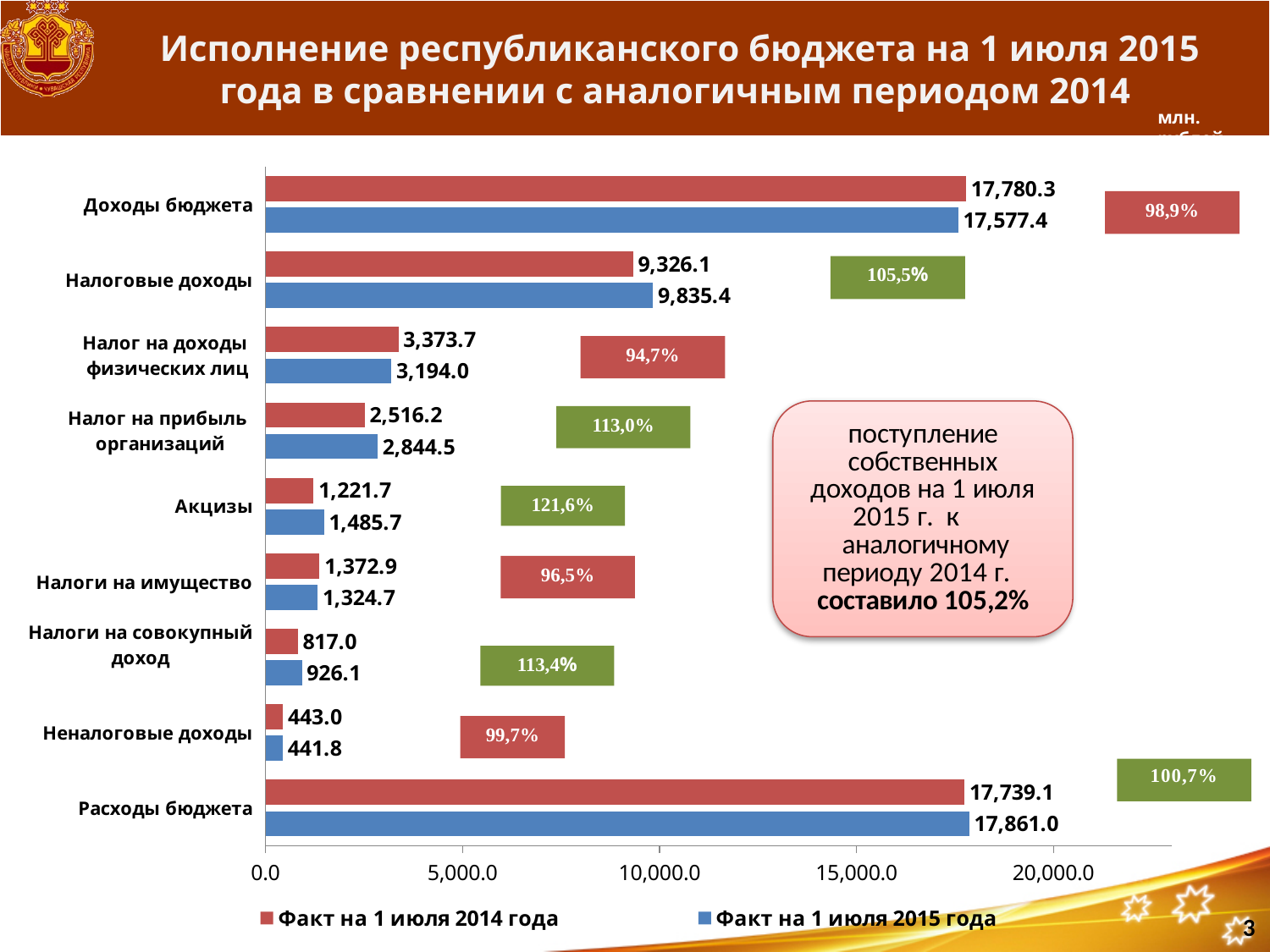
Which category has the highest value for "Факт на 1 июля 2014 года"? Доходы бюджета How many series does the legend list? 2 What is the value of "Факт на 1 июля 2014 года" for "Акцизы"? 1,221.7 What is the difference between the 2015 and 2014 values for "Акцизы"? 264.0 Which colour represents "Факт на 1 июля 2015 года" in the chart? blue How many categories are plotted on the chart? 9 For "Налог на доходы физических лиц", which is larger: the value for 2014 or for 2015? 2014 What is the value of "Факт на 1 июля 2015 года" for "Расходы бюджета"? 17,861.0 What is the difference between the 2015 and 2014 values for "Налоговые доходы"? 509.3 Which category has the lowest value for "Факт на 1 июля 2015 года"? Неналоговые доходы What kind of chart is shown on the slide? bar chart What is the value of "Факт на 1 июля 2015 года" for "Налоговые доходы"? 9,835.4